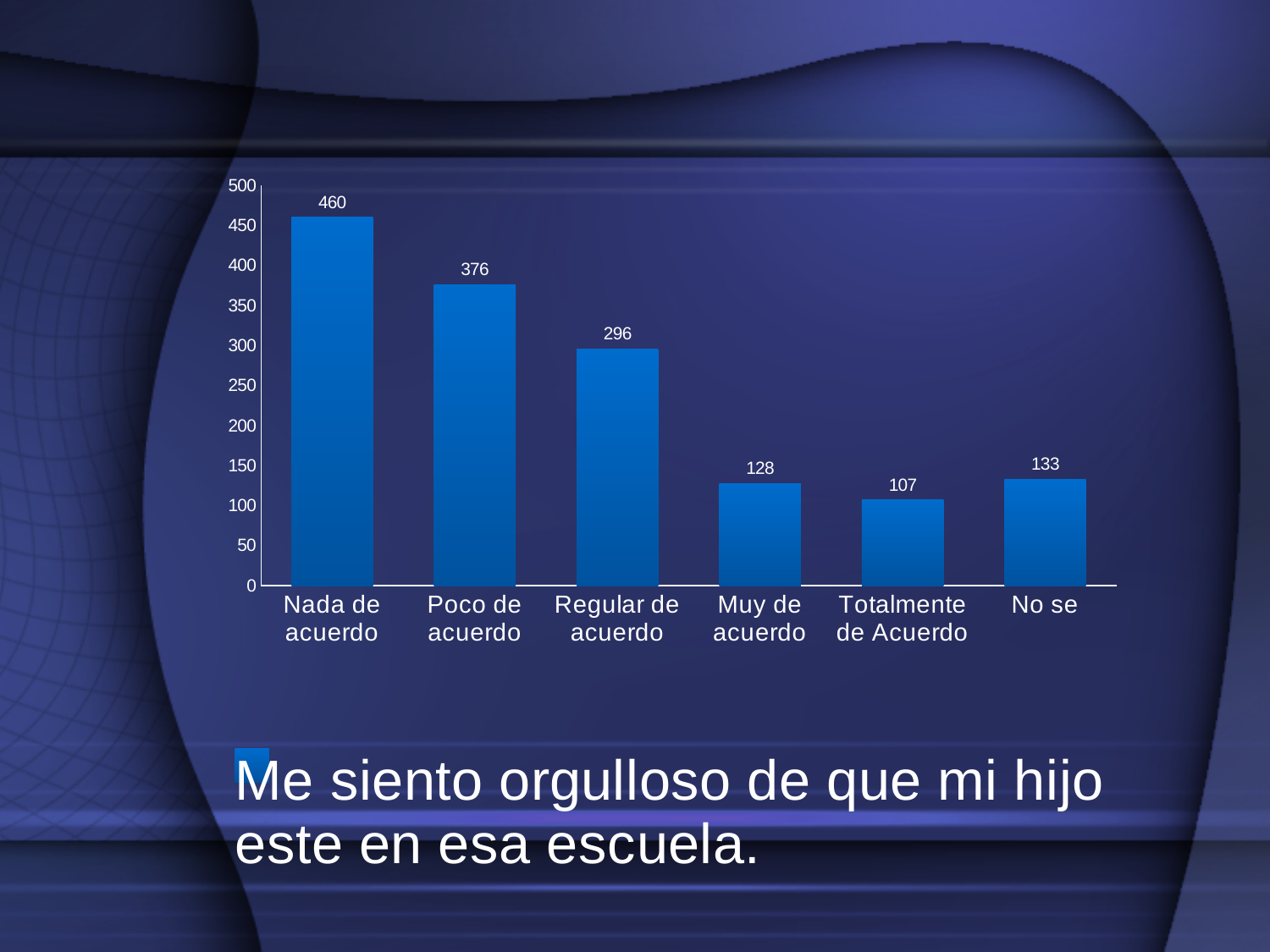
What is the difference between the values for "Nada de acuerdo" and "Poco de acuerdo"? 84 How many categories are shown on the x axis? 6 What kind of chart is shown on the slide? bar chart Which category has the lowest value? Totalmente de Acuerdo What is the value for "No se"? 133 What is the value for "Regular de acuerdo"? 296 What is the difference between the values for "No se" and "Totalmente de Acuerdo"? 26 Which category has the highest value? Nada de acuerdo Which is larger, the value for "Muy de acuerdo" or the value for "No se"? No se What is the value for "Nada de acuerdo"? 460 What is the text shown below the chart? Me siento orgulloso de que mi hijo este en esa escuela. Is the value for "Poco de acuerdo" greater or less than 350? greater